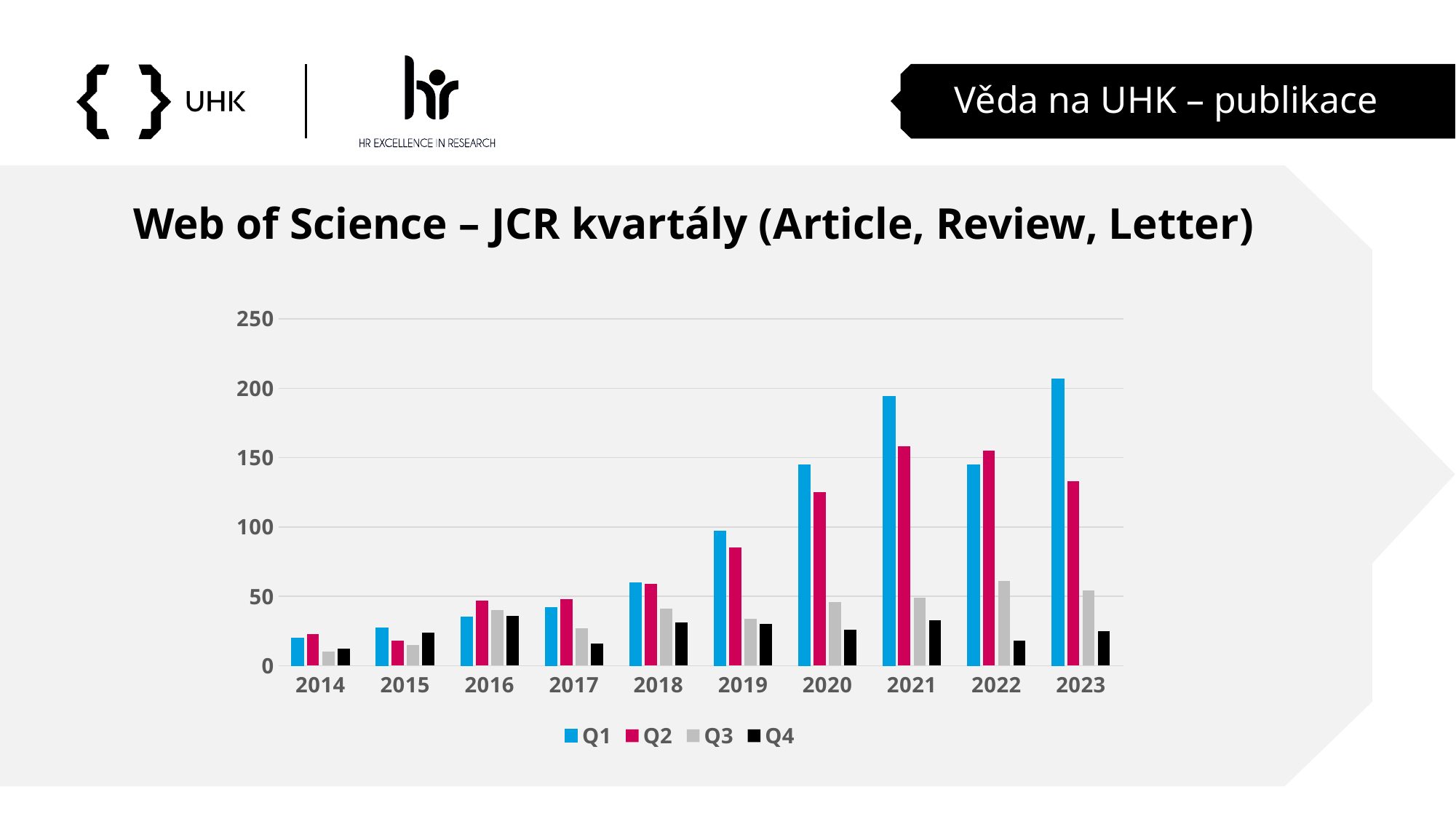
Is the Q2 value for 2021 greater or less than 150? greater How many years are shown on the x axis? 10 Is the Q1 value for 2023 greater or less than 200? greater What kind of chart is shown on the slide? bar chart Is the Q3 value for 2022 greater or less than 50? greater In 2020, which is larger, the Q1 value or the Q2 value? Q1 In 2022, which is larger, the Q1 value or the Q2 value? Q2 Does the Q1 value rise or fall from 2014 to 2021? rise In which year is the Q1 value highest? 2023 How many series does the legend list? 4 In which year is the Q1 value lowest? 2014